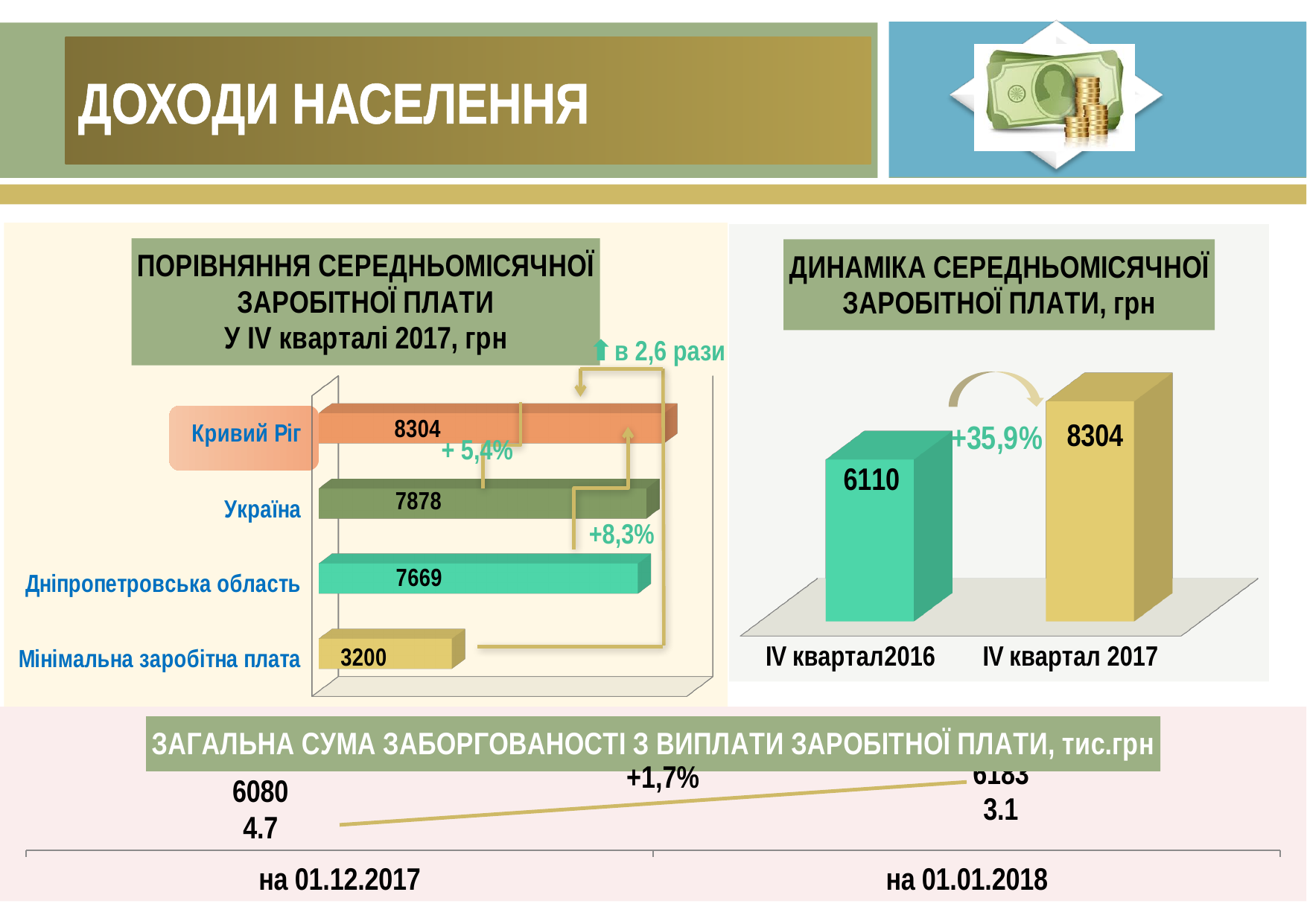
In the chart 'ЗАГАЛЬНА СУМА ЗАБОРГОВАНОСТІ З ВИПЛАТИ ЗАРОБІТНОЇ ПЛАТИ, тис.грн', what is the value for на 01.12.2017? 60804.7 In the chart 'ПОРІВНЯННЯ СЕРЕДНЬОМІСЯЧНОЇ ЗАРОБІТНОЇ ПЛАТИ У IV кварталі 2017, грн', what is the value for Кривий Ріг? 8304 How many categories are shown in the chart 'ПОРІВНЯННЯ СЕРЕДНЬОМІСЯЧНОЇ ЗАРОБІТНОЇ ПЛАТИ У IV кварталі 2017, грн'? 4 In the chart 'ПОРІВНЯННЯ СЕРЕДНЬОМІСЯЧНОЇ ЗАРОБІТНОЇ ПЛАТИ У IV кварталі 2017, грн', which category has the highest value? Кривий Ріг In the chart 'ПОРІВНЯННЯ СЕРЕДНЬОМІСЯЧНОЇ ЗАРОБІТНОЇ ПЛАТИ У IV кварталі 2017, грн', what is the value for Дніпропетровська область? 7669 In the chart 'ПОРІВНЯННЯ СЕРЕДНЬОМІСЯЧНОЇ ЗАРОБІТНОЇ ПЛАТИ У IV кварталі 2017, грн', what is the difference between the values for Кривий Ріг and Україна? 426 In the chart 'ДИНАМІКА СЕРЕДНЬОМІСЯЧНОЇ ЗАРОБІТНОЇ ПЛАТИ, грн', what is the difference between IV квартал 2017 and IV квартал 2016? 2194 In the chart 'ПОРІВНЯННЯ СЕРЕДНЬОМІСЯЧНОЇ ЗАРОБІТНОЇ ПЛАТИ У IV кварталі 2017, грн', which category has the lowest value? Мінімальна заробітна плата In the chart 'ДИНАМІКА СЕРЕДНЬОМІСЯЧНОЇ ЗАРОБІТНОЇ ПЛАТИ, грн', what is the value for IV квартал 2016? 6110 In the chart 'ДИНАМІКА СЕРЕДНЬОМІСЯЧНОЇ ЗАРОБІТНОЇ ПЛАТИ, грн', what percentage change is shown between IV квартал 2016 and IV квартал 2017? +35,9% What kind of chart is 'ПОРІВНЯННЯ СЕРЕДНЬОМІСЯЧНОЇ ЗАРОБІТНОЇ ПЛАТИ У IV кварталі 2017, грн'? Bar chart In the chart 'ПОРІВНЯННЯ СЕРЕДНЬОМІСЯЧНОЇ ЗАРОБІТНОЇ ПЛАТИ У IV кварталі 2017, грн', what is the value for Україна? 7878